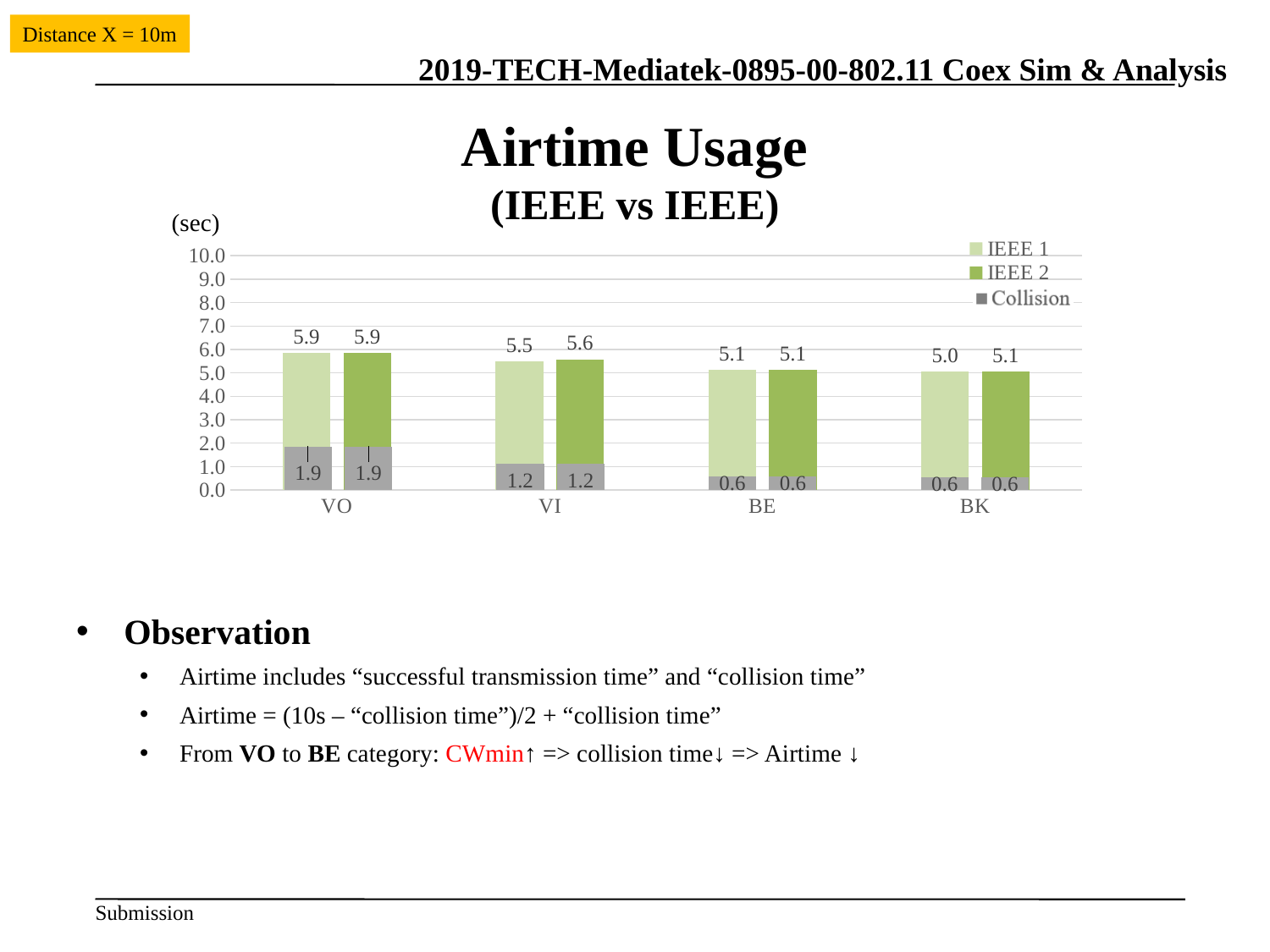
Which category has the highest IEEE 1 airtime value? VO Which category has the lowest IEEE 1 airtime value? BK What collision time is labelled for the BE category? 0.6 What is the IEEE 1 airtime value for the VO category? 5.9 What is the IEEE 2 airtime value for the VI category? 5.6 How many categories are shown on the x axis? 4 How many series does the legend list? 3 What kind of chart is shown on the slide? Bar chart What is the difference between the IEEE 1 values for VO and BK? 0.9 What is the IEEE 1 value for the BK category? 5.0 Which is larger, the IEEE 2 value for VI or the IEEE 2 value for BE? IEEE 2 value for VI What collision time is labelled for the VO category? 1.9